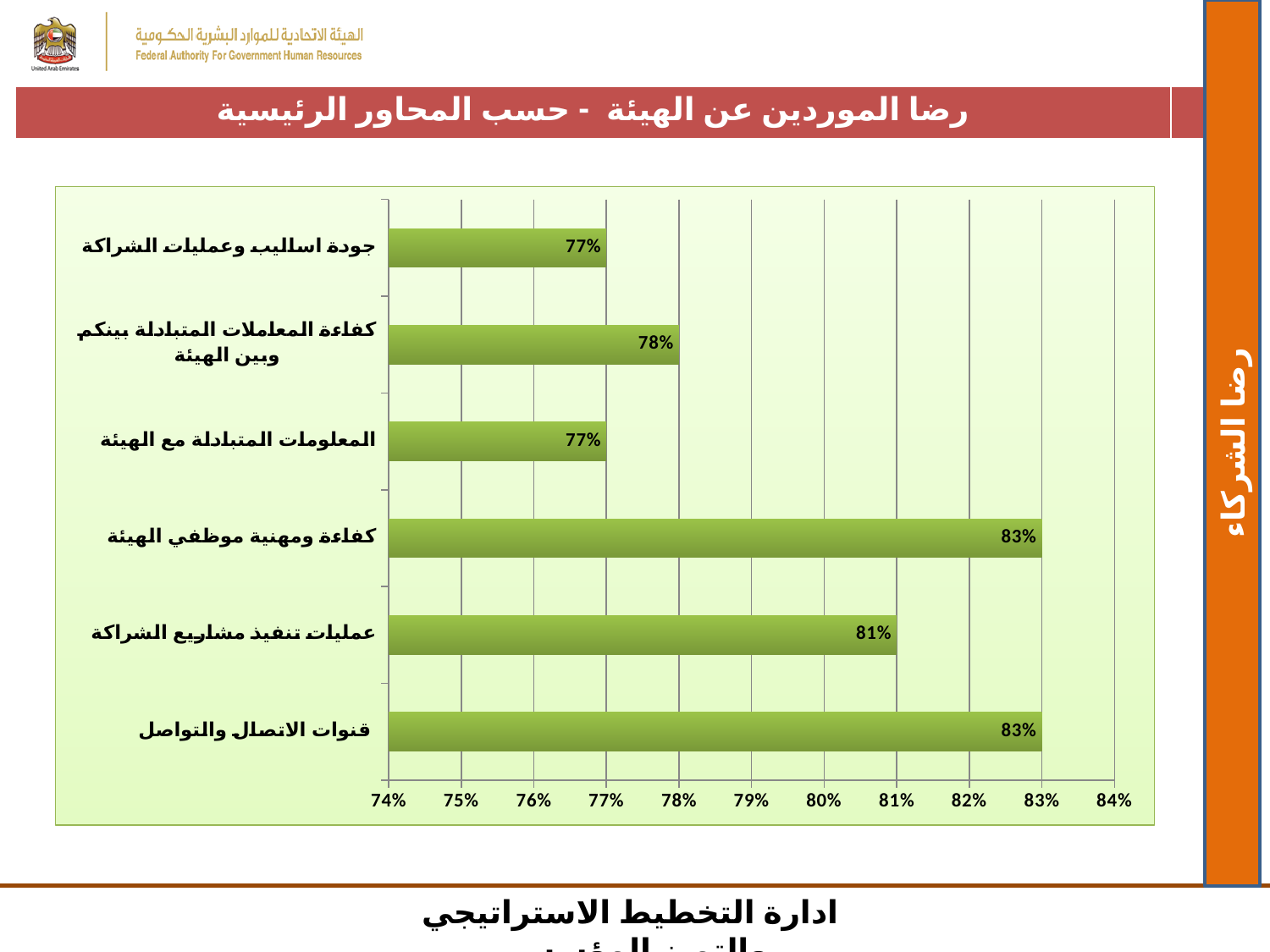
Is the value for عمليات تنفيذ مشاريع الشراكة greater or less than 80%? greater What is the value for قنوات الاتصال والتواصل? 83% What is the title of the chart on the slide? رضا الموردين عن الهيئة - حسب المحاور الرئيسية What is the value for عمليات تنفيذ مشاريع الشراكة? 81% What kind of chart is shown on the slide? bar chart What is the value for المعلومات المتبادلة مع الهيئة? 77% Which is larger, the value for كفاءة المعاملات المتبادلة بينكم وبين الهيئة or the value for المعلومات المتبادلة مع الهيئة? كفاءة المعاملات المتبادلة بينكم وبين الهيئة What is the difference between the values for كفاءة ومهنية موظفي الهيئة and عمليات تنفيذ مشاريع الشراكة? 2% What is the value for كفاءة ومهنية موظفي الهيئة? 83% What is the value for جودة اساليب وعمليات الشراكة? 77% What is the value for كفاءة المعاملات المتبادلة بينكم وبين الهيئة? 78% How many categories are shown in the chart? 6